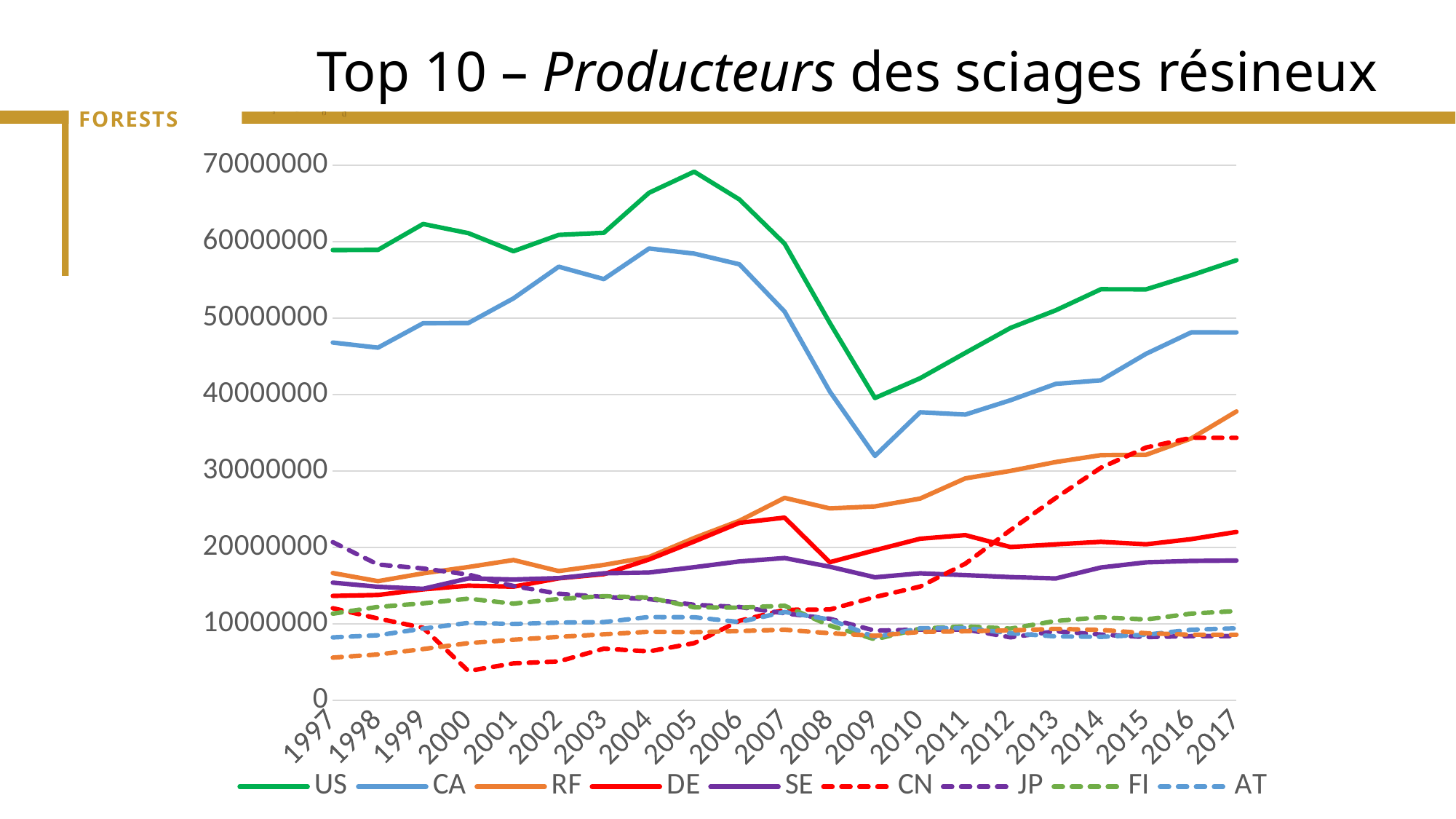
Is the value for RF in 2017 greater or less than 30000000? greater Is the value for CN in 2000 greater or less than 10000000? less What kind of chart is shown on the slide? line chart Is the value for US in 2005 greater or less than 60000000? greater Which series has the highest value in 2005? US Does the US line rise or fall between 2005 and 2009? fall Does the CN line rise or fall between 2009 and 2017? rise Which is larger in 2017, the value for US or the value for CA? US How many series does the legend list? 9 How many years are shown along the x axis? 21 Which is larger in 2017, the value for RF or the value for DE? RF